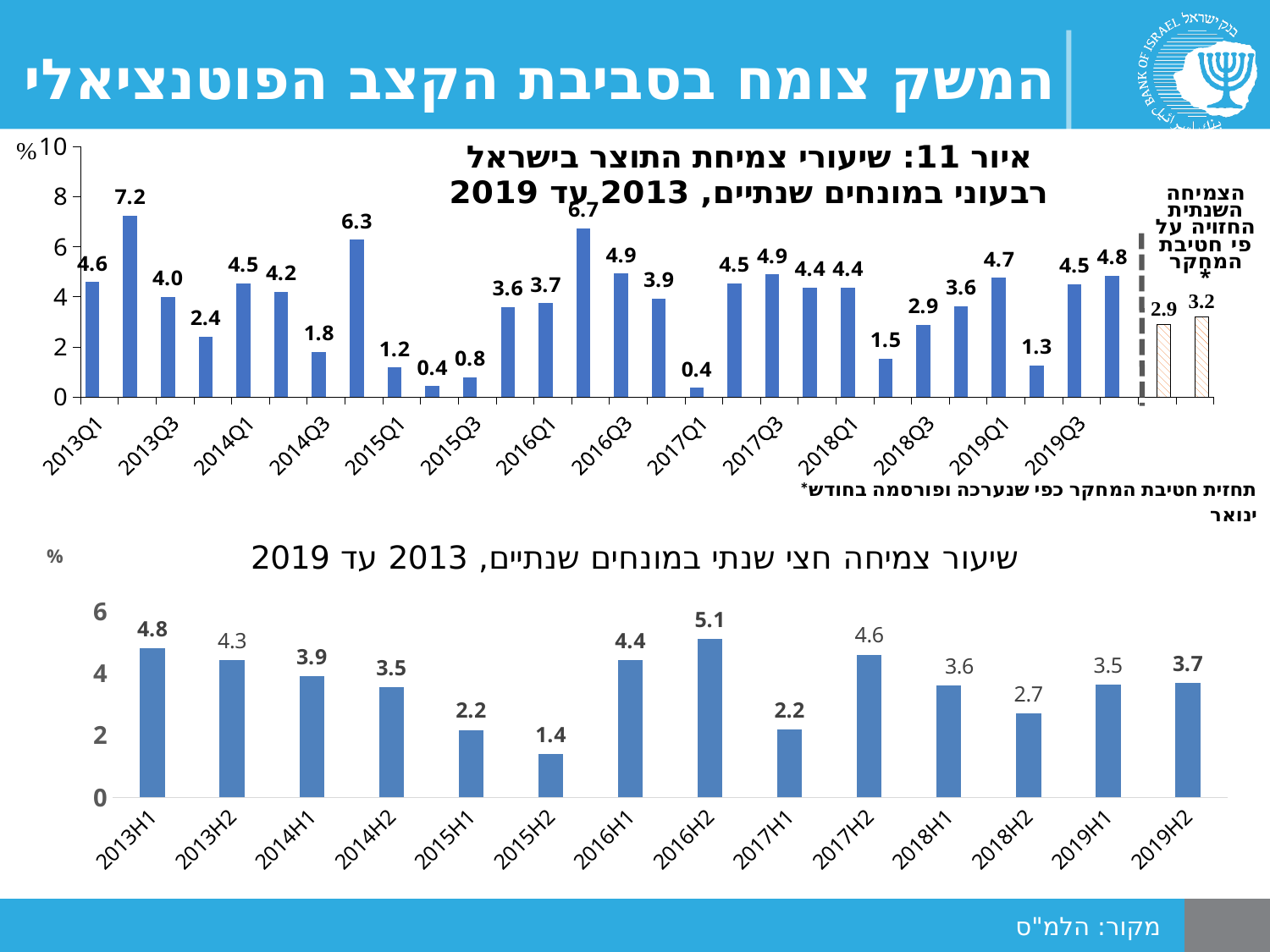
What kind of chart is the bottom chart? Bar chart How many half-year bars are plotted in the bottom chart? 14 In the top chart, which is larger, the value for 2013Q1 or the value for 2015Q1? 2013Q1 In the bottom chart, what is the value for 2015H2? 1.4 In the bottom chart, which half-year has the lowest value? 2015H2 In the bottom chart, what is the value for 2016H2? 5.1 In the top chart, what is the value for 2017Q1? 0.4 In the bottom chart, which half-year has the highest value? 2016H2 In the top chart, what is the value for 2019Q1? 4.7 In the top chart, what is the difference between the values for 2016Q3 and 2018Q3? 2.0 In the bottom chart, what is the difference between the values for 2013H1 and 2019H2? 1.1 In the bottom chart, which is larger, the value for 2017H2 or the value for 2018H2? 2017H2